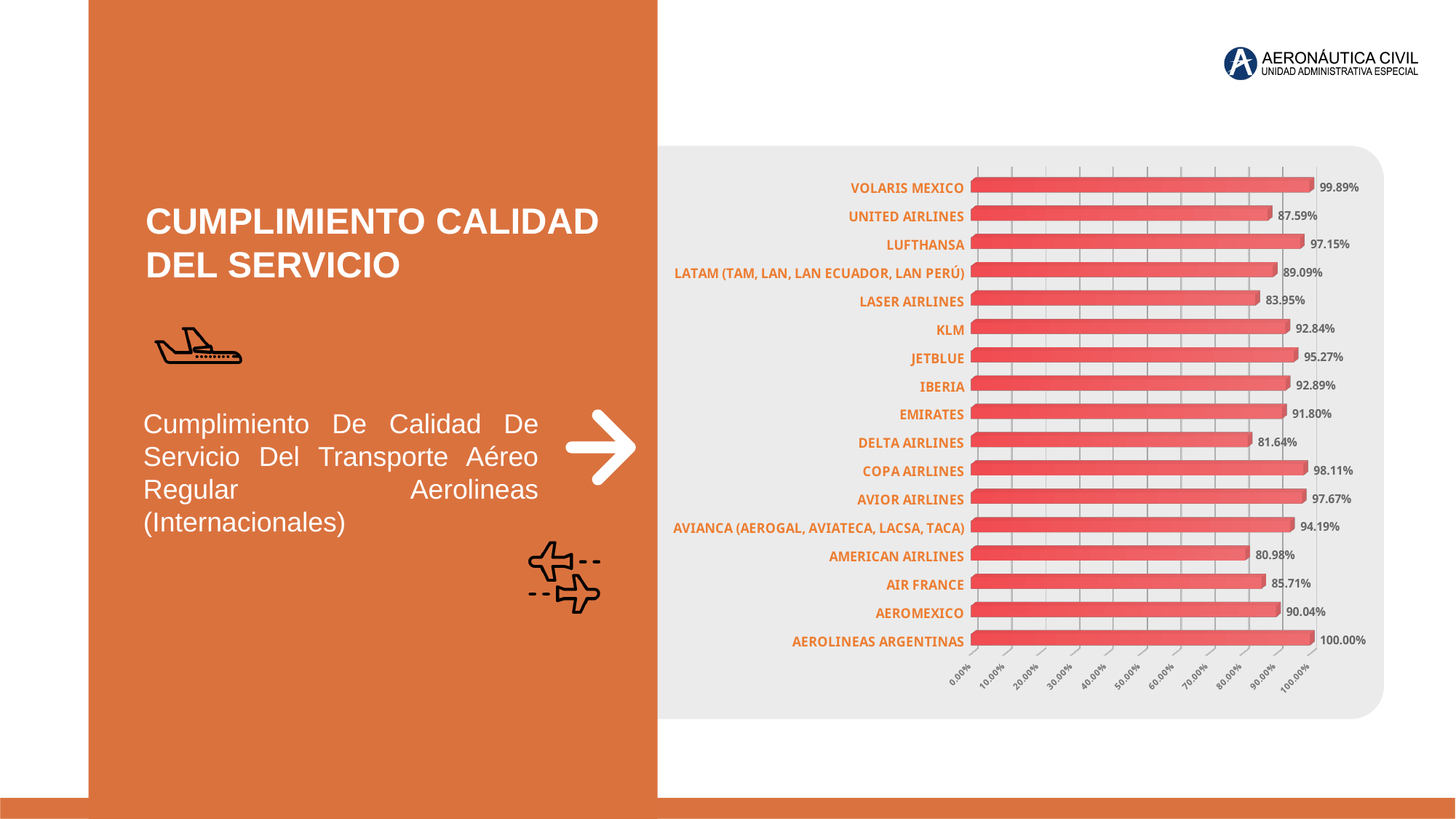
What type of chart is shown on the slide? bar chart Which airline has the highest value in the chart? AEROLINEAS ARGENTINAS What is the value shown for LUFTHANSA? 97.15% Which airline has the lowest value in the chart? AMERICAN AIRLINES What is the value shown for AVIANCA (AEROGAL, AVIATECA, LACSA, TACA)? 94.19% What is the difference between the values for COPA AIRLINES and DELTA AIRLINES? 16.47% Is the value for AIR FRANCE greater or less than 90.00%? less What is the value shown for AEROMEXICO? 90.04% How many airlines are shown in the chart? 17 Which has a higher value, JETBLUE or LASER AIRLINES? JETBLUE What is the value shown for DELTA AIRLINES? 81.64% What is the difference between the values for VOLARIS MEXICO and UNITED AIRLINES? 12.30%